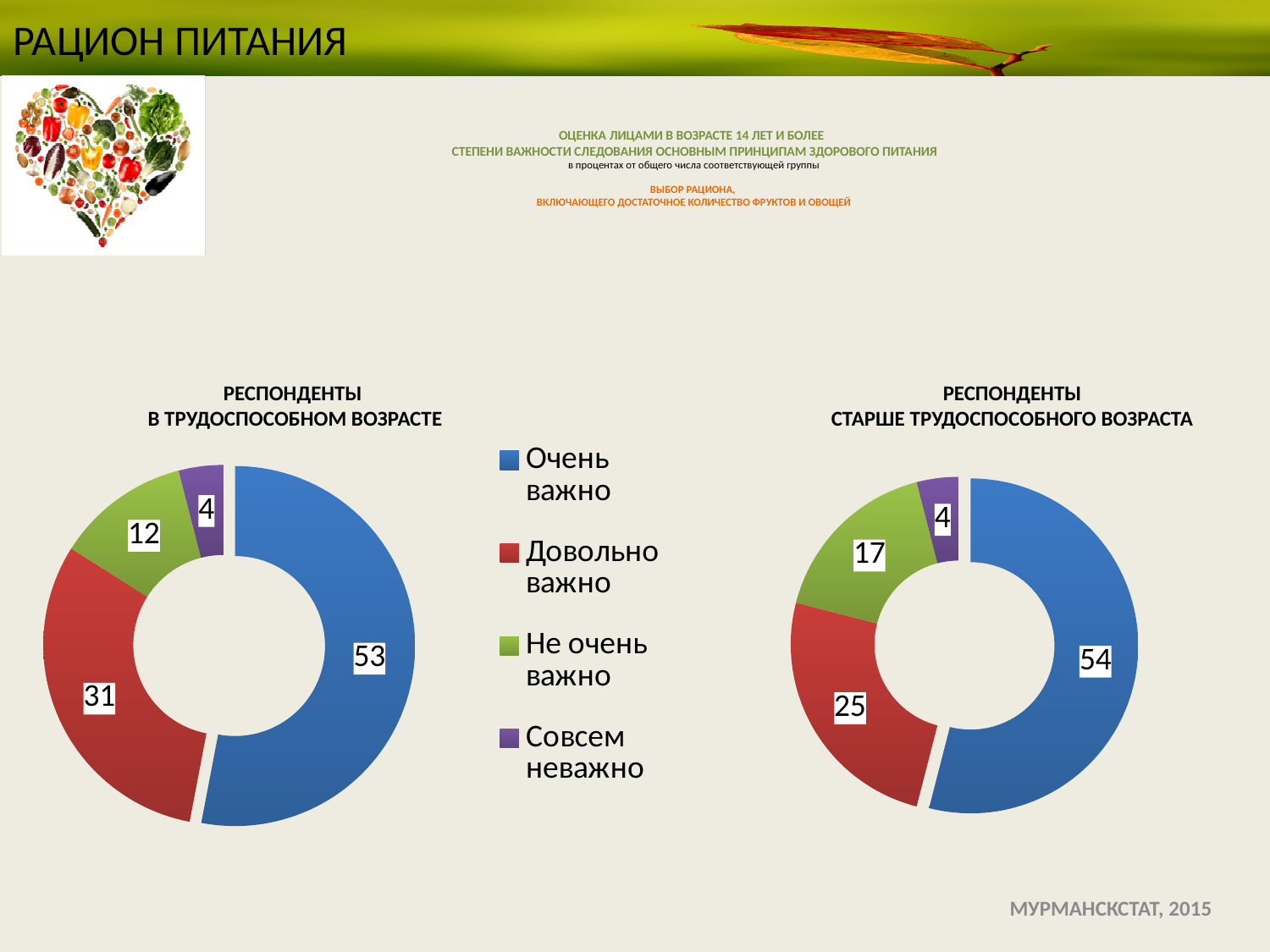
In the chart titled «РЕСПОНДЕНТЫ СТАРШЕ ТРУДОСПОСОБНОГО ВОЗРАСТА», what is the difference between the values for «Довольно важно» and «Не очень важно»? 8 In the chart titled «РЕСПОНДЕНТЫ СТАРШЕ ТРУДОСПОСОБНОГО ВОЗРАСТА», what is the value for «Довольно важно»? 25 How many entries does the shared legend between the two charts list? 4 In the chart titled «РЕСПОНДЕНТЫ СТАРШЕ ТРУДОСПОСОБНОГО ВОЗРАСТА», what is the value for «Не очень важно»? 17 Which chart has the larger value for «Не очень важно»: «РЕСПОНДЕНТЫ В ТРУДОСПОСОБНОМ ВОЗРАСТЕ» or «РЕСПОНДЕНТЫ СТАРШЕ ТРУДОСПОСОБНОГО ВОЗРАСТА»? РЕСПОНДЕНТЫ СТАРШЕ ТРУДОСПОСОБНОГО ВОЗРАСТА What type of chart is «РЕСПОНДЕНТЫ СТАРШЕ ТРУДОСПОСОБНОГО ВОЗРАСТА»? Doughnut chart In the chart titled «РЕСПОНДЕНТЫ В ТРУДОСПОСОБНОМ ВОЗРАСТЕ», what is the difference between the values for «Очень важно» and «Довольно важно»? 22 In the chart titled «РЕСПОНДЕНТЫ В ТРУДОСПОСОБНОМ ВОЗРАСТЕ», what is the value for «Очень важно»? 53 In the legend, which colour represents «Совсем неважно»? Purple In the chart titled «РЕСПОНДЕНТЫ В ТРУДОСПОСОБНОМ ВОЗРАСТЕ», how many categories are shown? 4 In the chart titled «РЕСПОНДЕНТЫ СТАРШЕ ТРУДОСПОСОБНОГО ВОЗРАСТА», which category has the smallest share? Совсем неважно In the chart titled «РЕСПОНДЕНТЫ В ТРУДОСПОСОБНОМ ВОЗРАСТЕ», which category has the largest share? Очень важно